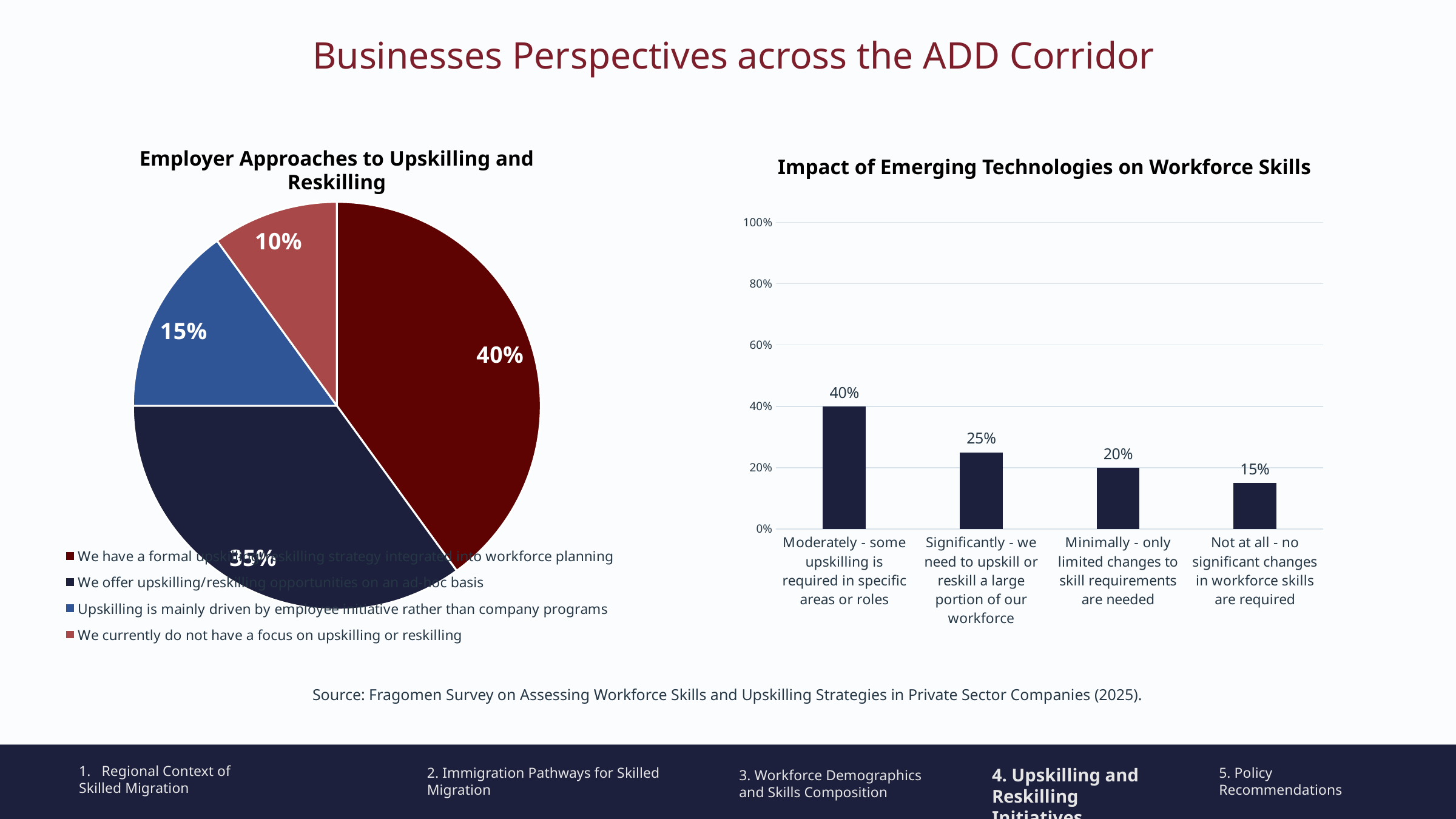
What type of chart is 'Employer Approaches to Upskilling and Reskilling'? Pie chart In the 'Employer Approaches to Upskilling and Reskilling' pie chart, what share is shown for 'We have a formal upskilling/reskilling strategy integrated into workforce planning'? 40% In the 'Impact of Emerging Technologies on Workforce Skills' chart, what is the value for 'Significantly - we need to upskill or reskill a large portion of our workforce'? 25% In the 'Impact of Emerging Technologies on Workforce Skills' chart, which is larger: 'Minimally' or 'Not at all'? Minimally In the 'Impact of Emerging Technologies on Workforce Skills' chart, what is the difference between 'Moderately' and 'Not at all'? 25% In the 'Employer Approaches to Upskilling and Reskilling' pie chart, what is the difference between the 'ad-hoc basis' slice and the 'employee initiative' slice? 20% In the 'Impact of Emerging Technologies on Workforce Skills' chart, which category has the highest value? Moderately - some upskilling is required in specific areas or roles In the 'Employer Approaches to Upskilling and Reskilling' pie chart, what share is shown for 'We currently do not have a focus on upskilling or reskilling'? 10% In the 'Employer Approaches to Upskilling and Reskilling' pie chart, which category has the smallest slice? We currently do not have a focus on upskilling or reskilling What type of chart is 'Impact of Emerging Technologies on Workforce Skills'? Bar chart In the 'Impact of Emerging Technologies on Workforce Skills' chart, do the values rise or fall from left to right? Fall In the 'Employer Approaches to Upskilling and Reskilling' pie chart, how many slices are there? 4